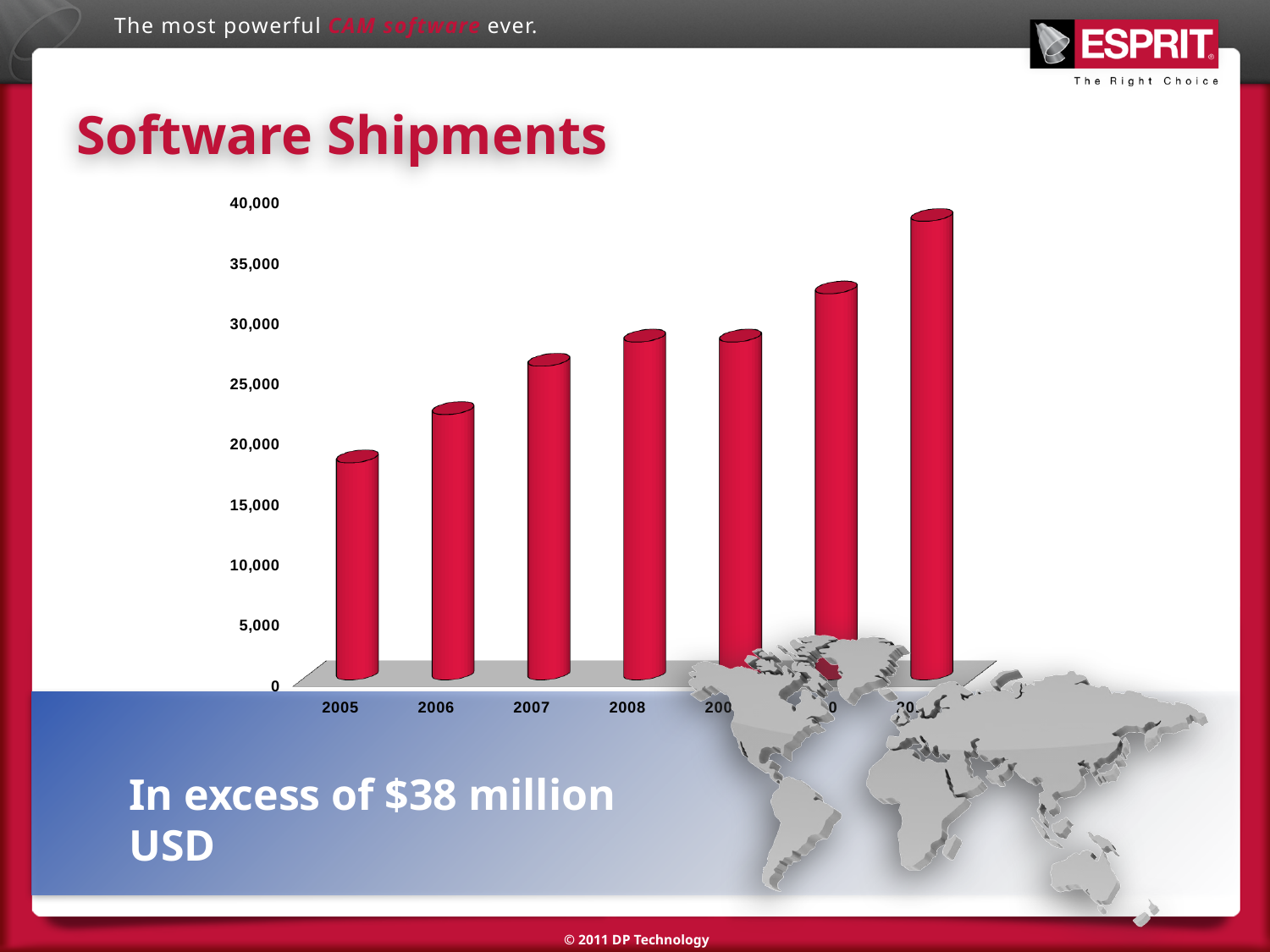
Is the tallest bar in the Software Shipments chart greater or less than 35,000? greater Which is larger, the value for 2007 or the value for 2008? 2008 What is the title of the chart on the slide? Software Shipments Do the values in the Software Shipments chart generally rise or fall from left to right? Rise Is the value for 2008 greater or less than 30,000? less Which year has the lowest value in the Software Shipments chart? 2005 Is the value for 2005 greater or less than 20,000? less Which is larger, the value for 2005 or the value for 2006? 2006 How many bars are plotted in the Software Shipments chart? 7 What kind of chart is shown on the slide? Bar chart